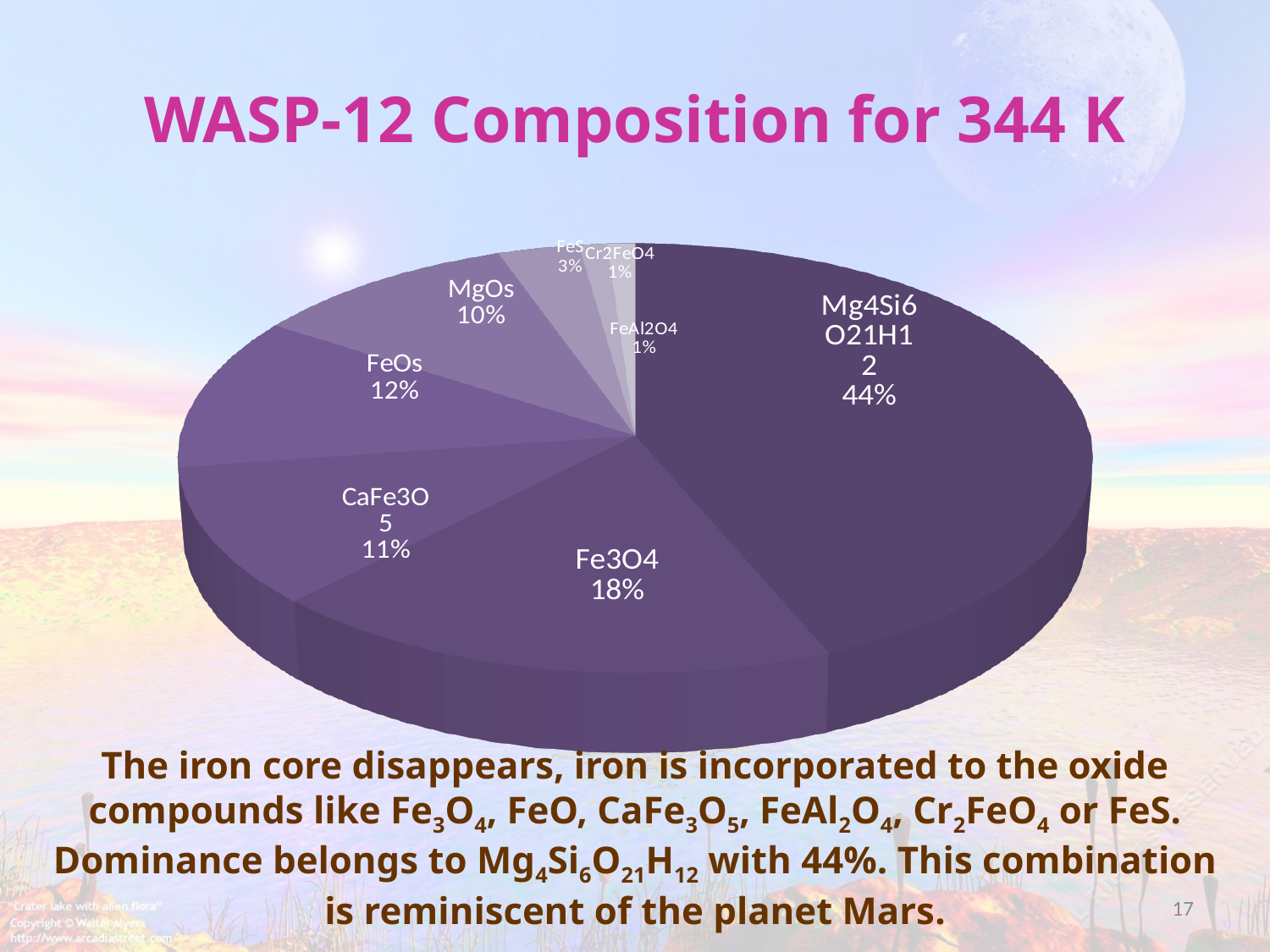
What is the difference in percentage points between FeOs and MgOs? 2 What percentage is shown for CaFe3O5? 11% What is the title of the chart? WASP-12 Composition for 344 K How many slices does the pie chart have? 8 What percentage is shown for FeOs? 12% What percentage is shown for FeS? 3% What type of chart is shown on the slide? pie chart Which compound has the largest slice of the pie? Mg4Si6O21H12 What is the difference in percentage points between Mg4Si6O21H12 and Fe3O4? 26 What share of the pie does Mg4Si6O21H12 have? 44% Which has a larger share, FeOs or MgOs? FeOs What share of the pie does Fe3O4 have? 18%